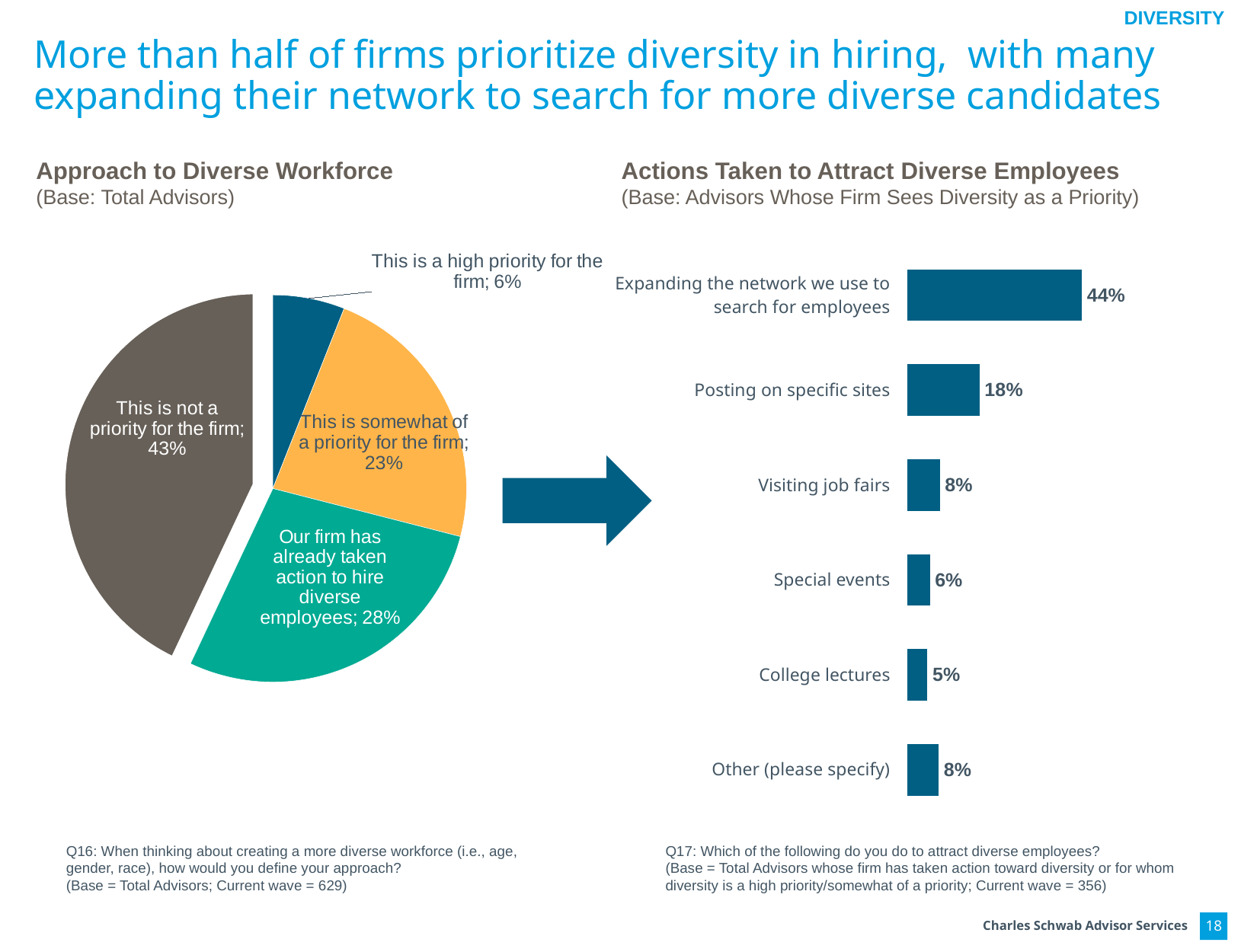
In the 'Approach to Diverse Workforce' chart, what share of advisors say this is a high priority for the firm? 6% What kind of chart is 'Approach to Diverse Workforce'? Pie chart In the 'Approach to Diverse Workforce' chart, what share of advisors say this is not a priority for the firm? 43% In the 'Approach to Diverse Workforce' chart, how many slices does the pie have? 4 In the 'Approach to Diverse Workforce' chart, which response has the smallest slice? This is a high priority for the firm What kind of chart is 'Actions Taken to Attract Diverse Employees'? Bar chart In the 'Actions Taken to Attract Diverse Employees' chart, which action has the highest value? Expanding the network we use to search for employees In the 'Actions Taken to Attract Diverse Employees' chart, what is the value for 'Posting on specific sites'? 18% In the 'Actions Taken to Attract Diverse Employees' chart, which action has the lowest value? College lectures In the 'Approach to Diverse Workforce' chart, what is the difference between the share for 'Our firm has already taken action to hire diverse employees' and 'This is somewhat of a priority for the firm'? 5% In the 'Actions Taken to Attract Diverse Employees' chart, what is the difference between 'Expanding the network we use to search for employees' and 'Posting on specific sites'? 26% In the 'Approach to Diverse Workforce' chart, which response has the largest slice? This is not a priority for the firm